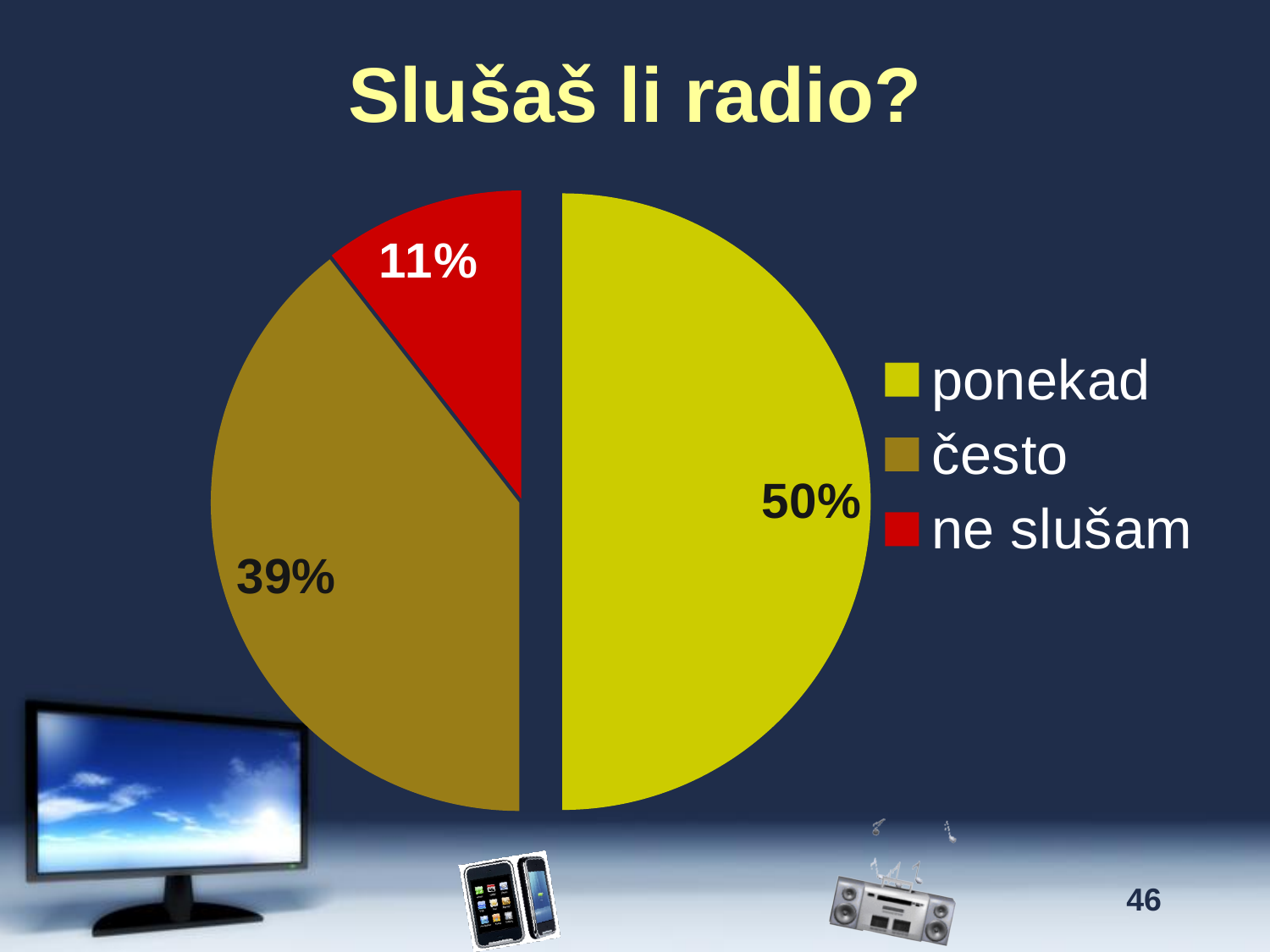
What is the difference in percentage points between "ponekad" and "često"? 11 Which category has the largest share of the pie? ponekad What kind of chart is shown on the slide? pie chart What percentage of the pie is labelled "ponekad"? 50% What percentage of the pie is labelled "često"? 39% What is the title of the slide above the chart? Slušaš li radio? What percentage of the pie is labelled "ne slušam"? 11% What colour is the slice for "ne slušam"? red What is the difference in percentage points between "često" and "ne slušam"? 28 Which category has the smallest share of the pie? ne slušam How many categories does the legend list? 3 Which is larger, the share for "često" or the share for "ne slušam"? često